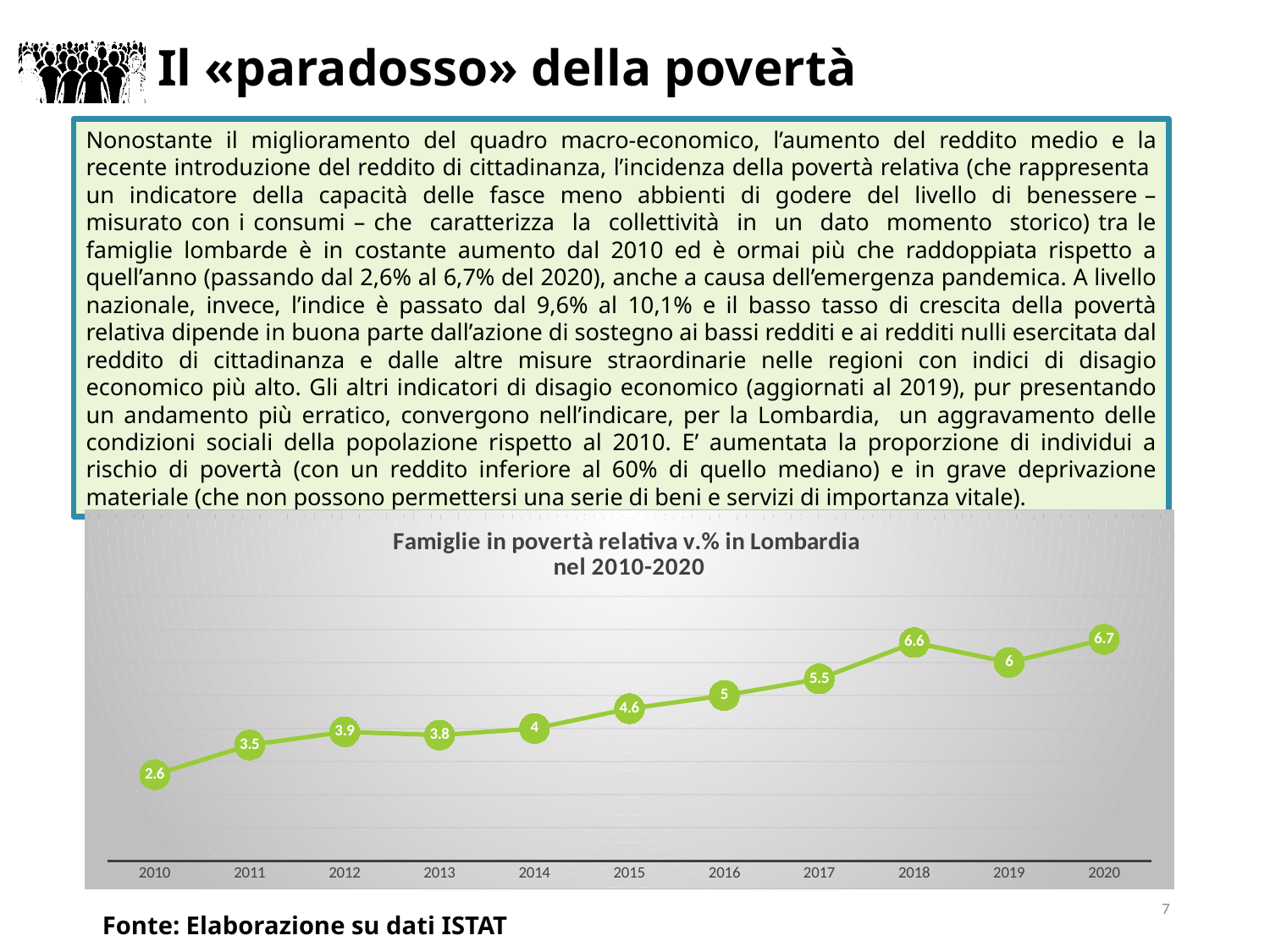
What is the difference between the values for 2018 and 2019? 0.6 Which year has the highest value in the chart? 2020 How many years are plotted on the x axis of the chart? 11 Which year has the lowest value in the chart? 2010 What is the value for 2010 in the chart? 2.6 What is the difference between the values for 2020 and 2010? 4.1 What is the value for 2014 in the chart? 4 Which is larger, the value for 2012 or the value for 2013? 2012 What is the value for 2018 in the chart? 6.6 Do the values generally rise or fall from 2010 to 2020? Rise What type of chart is shown on the slide? Line chart What is the title of the chart? Famiglie in povertà relativa v.% in Lombardia nel 2010-2020